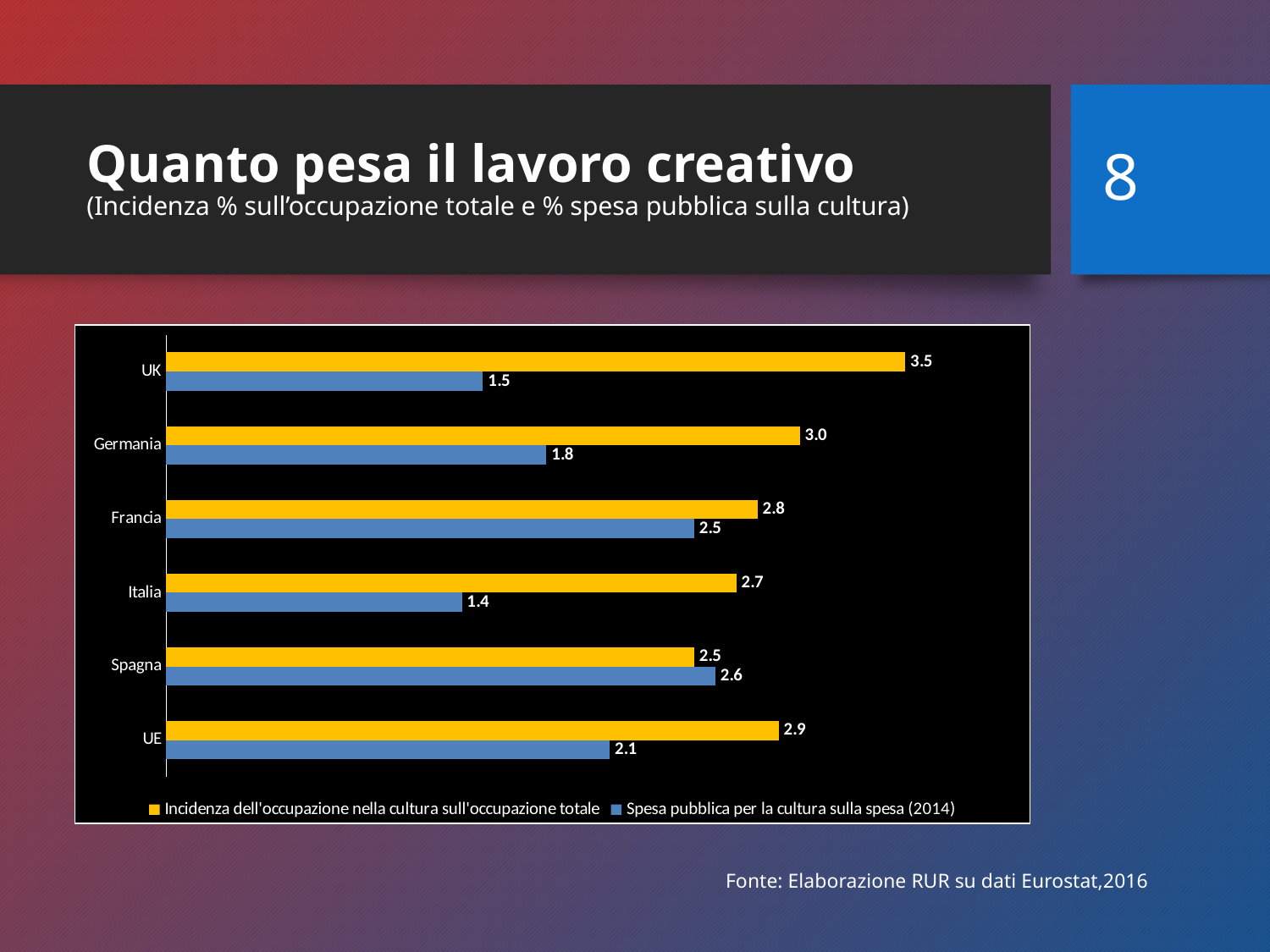
Which category has the highest value for 'Incidenza dell'occupazione nella cultura sull'occupazione totale'? UK What is the value of 'Spesa pubblica per la cultura sulla spesa (2014)' for Francia? 2.5 What is the value of 'Spesa pubblica per la cultura sulla spesa (2014)' for Italia? 1.4 How many series does the legend list? 2 Which category has the lowest value for 'Spesa pubblica per la cultura sulla spesa (2014)'? Italia How many categories are shown on the chart? 6 What is the value of 'Incidenza dell'occupazione nella cultura sull'occupazione totale' for UK? 3.5 What colour are the bars for 'Spesa pubblica per la cultura sulla spesa (2014)'? Blue Which is larger: the 'Incidenza dell'occupazione nella cultura sull'occupazione totale' value for Germania or for UE? Germania What kind of chart is shown on the slide? Bar chart What is the difference between the two series values for Germania? 1.2 For Spagna, which series has the larger value? Spesa pubblica per la cultura sulla spesa (2014)